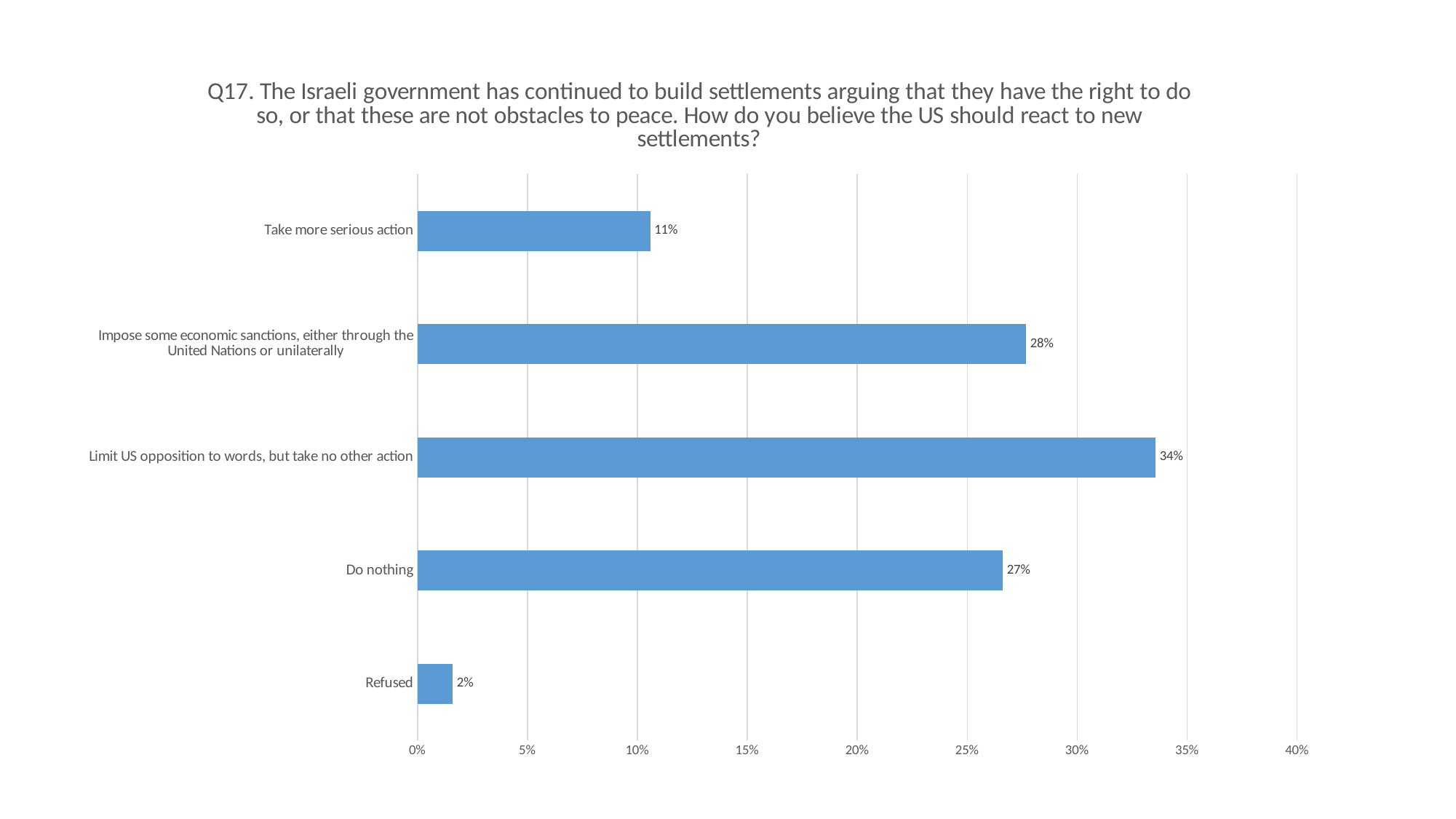
What kind of chart is shown on the slide? Bar chart What is the difference in percentage points between "Do nothing" and "Refused"? 25 How many response categories are shown in the chart? 5 Which response option has the highest percentage? Limit US opposition to words, but take no other action Which is larger: the value for "Impose some economic sanctions, either through the United Nations or unilaterally" or the value for "Do nothing"? Impose some economic sanctions, either through the United Nations or unilaterally What percentage is shown for "Impose some economic sanctions, either through the United Nations or unilaterally"? 28% What value is shown for "Do nothing"? 27% What is the difference in percentage points between "Limit US opposition to words, but take no other action" and "Take more serious action"? 23 What percentage of respondents chose "Take more serious action"? 11% What is the maximum value shown on the horizontal axis? 40% Is the value for "Limit US opposition to words, but take no other action" greater or less than 30%? greater Which response option has the lowest percentage? Refused